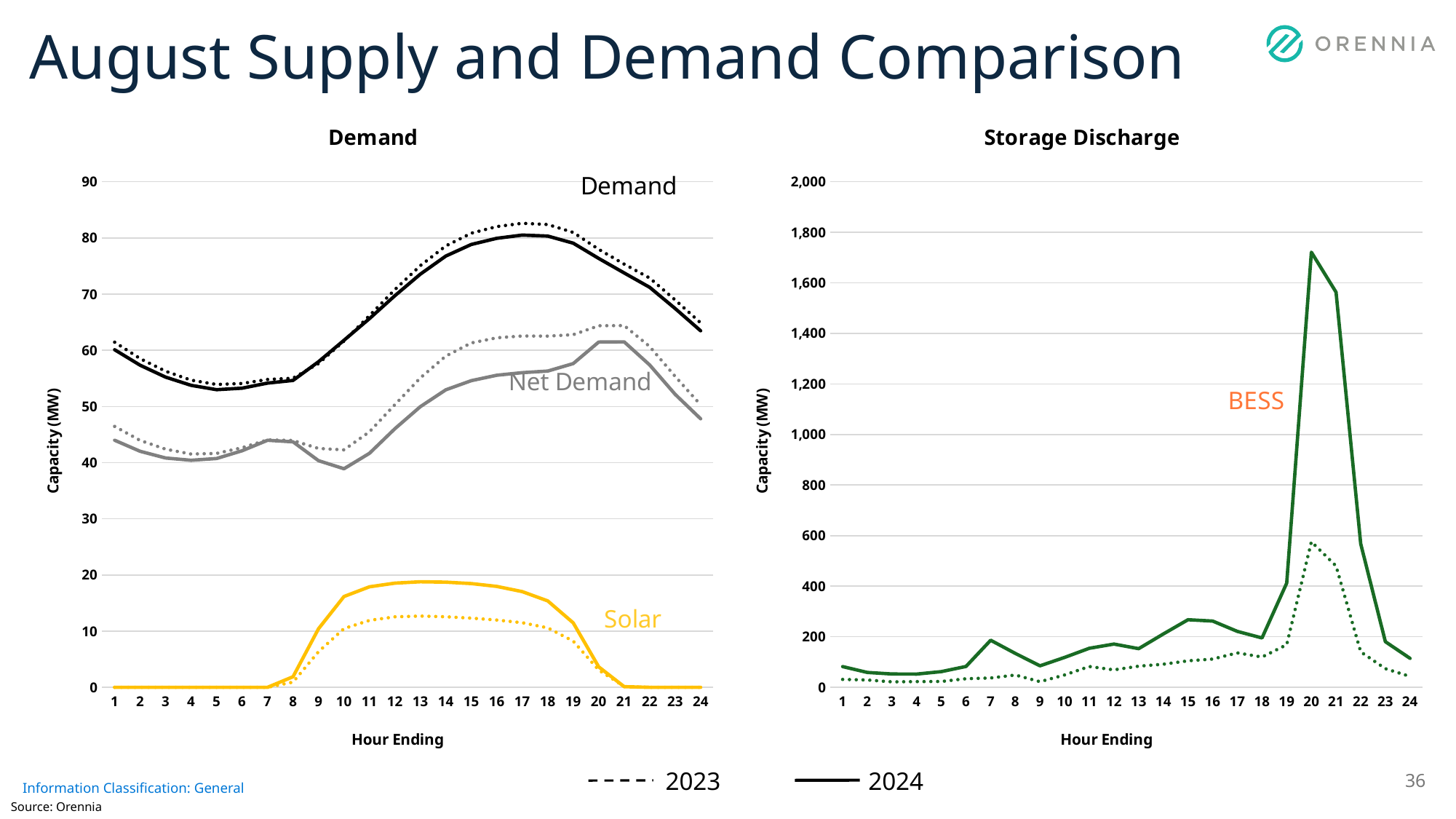
In the Demand chart, is the 2024 Solar value at hour ending 13 greater or less than 20? less How many hours are shown on the x axis of the Storage Discharge chart? 24 In the Demand chart, at hour ending 13, which is higher: 2024 Solar or 2023 Solar? 2024 Solar In the Storage Discharge chart, is the 2024 BESS value at hour ending 20 greater or less than 1,600? greater In the Storage Discharge chart, at which hour ending does the 2024 BESS line reach its highest value? 20 In the Demand chart, does the 2024 Demand line rise or fall from hour ending 17 to hour ending 24? fall In the Demand chart, at which hour ending is the 2024 Net Demand line at its lowest? 10 What kind of chart is the Demand chart on the left? line chart In the Storage Discharge chart, is the 2024 BESS value at hour ending 15 greater or less than 200? greater Which year does the dotted line style represent according to the legend? 2023